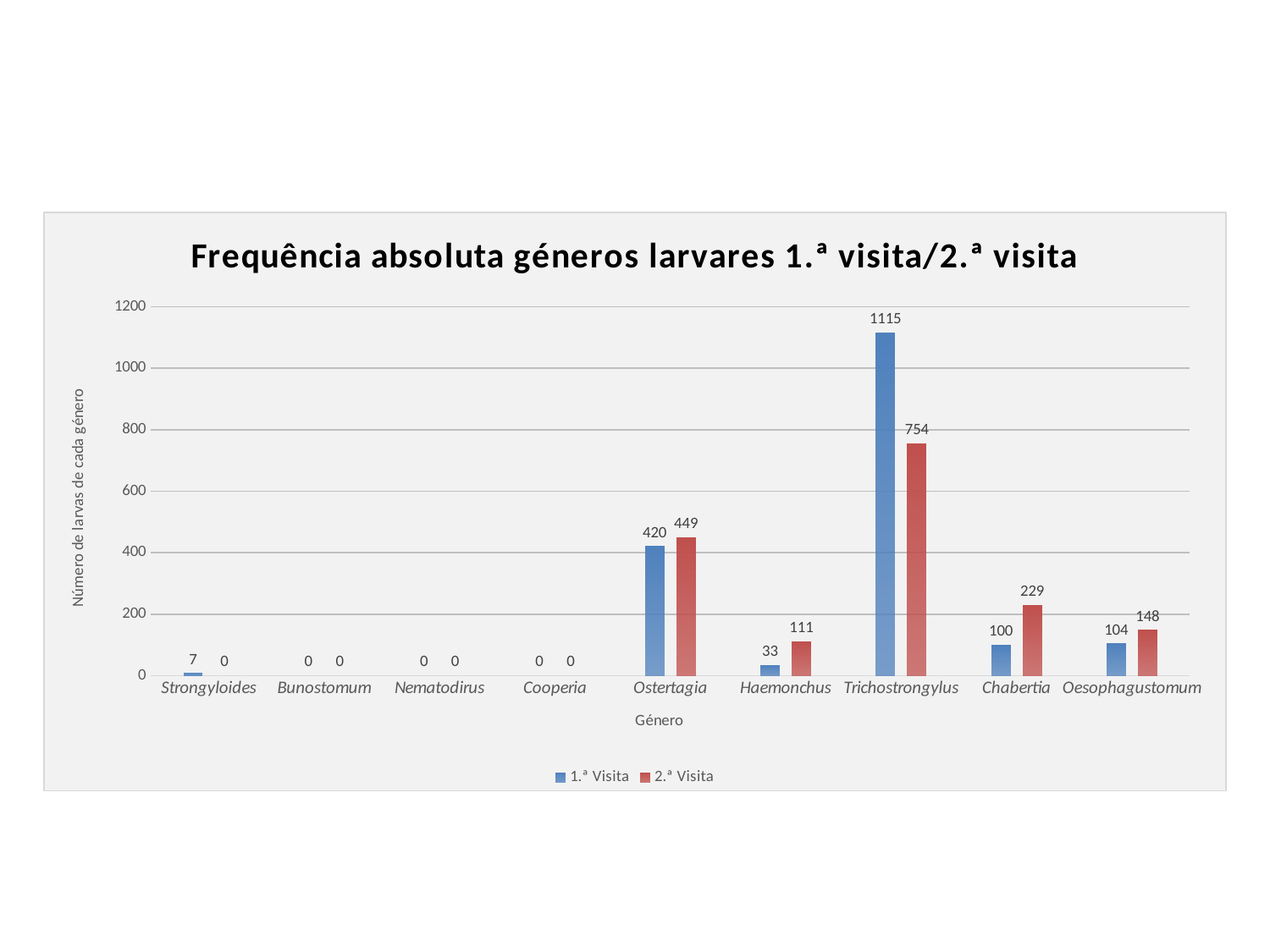
Which genus has the highest value in the 2.ª Visita series? Trichostrongylus What is the value for Haemonchus in the 1.ª Visita series? 33 What is the title of the chart? Frequência absoluta géneros larvares 1.ª visita/2.ª visita What is the value for Chabertia in the 2.ª Visita series? 229 Is the 2.ª Visita value for Trichostrongylus greater or less than 800? less How many series does the legend list? 2 Which is larger for Oesophagustomum: the 1.ª Visita value or the 2.ª Visita value? 2.ª Visita How many genera are shown on the x axis? 9 What is the value for Trichostrongylus in the 1.ª Visita series? 1115 What kind of chart is shown on the slide? bar chart What is the difference between the 2.ª Visita and 1.ª Visita values for Ostertagia? 29 What is the difference between the 1.ª Visita and 2.ª Visita values for Trichostrongylus? 361